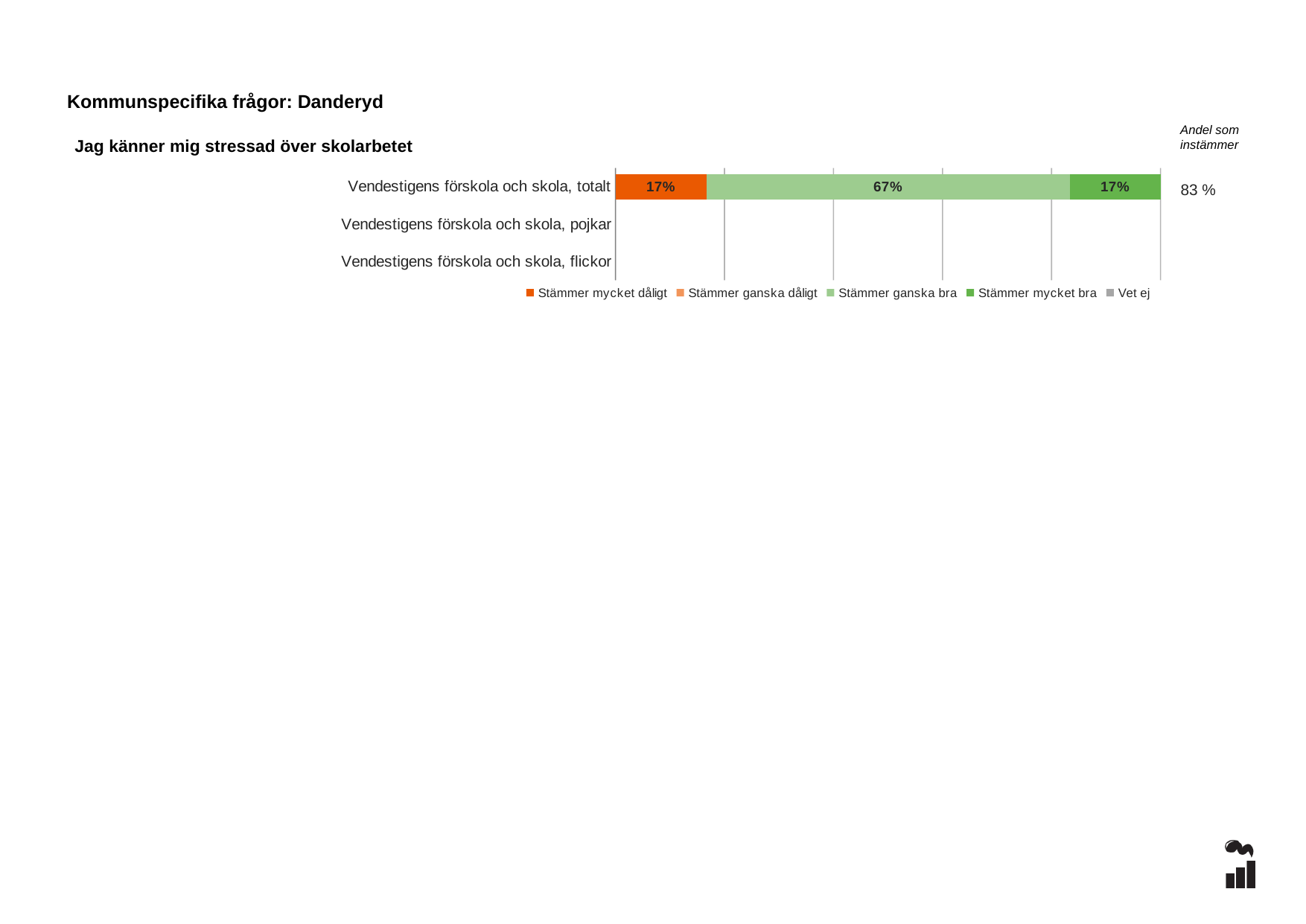
What is the value for 'Stämmer mycket bra' for Vendestigens förskola och skola, totalt? 17% Which response category has the largest share in the bar for Vendestigens förskola och skola, totalt? Stämmer ganska bra What is the 'Andel som instämmer' value shown for Vendestigens förskola och skola, totalt? 83 % What kind of chart is shown on the slide? Stacked bar chart What is the value for 'Stämmer ganska bra' for Vendestigens förskola och skola, totalt? 67% Which legend entry is shown in orange-red? Stämmer mycket dåligt What is the difference between the 'Stämmer ganska bra' value and the 'Stämmer mycket bra' value for Vendestigens förskola och skola, totalt? 50% How many series does the legend list? 5 What is the title of the chart? Jag känner mig stressad över skolarbetet How many category rows are listed on the y axis of the chart? 3 What is the value for 'Stämmer mycket dåligt' for Vendestigens förskola och skola, totalt? 17% Which is larger for Vendestigens förskola och skola, totalt: 'Stämmer ganska bra' or 'Stämmer mycket dåligt'? Stämmer ganska bra